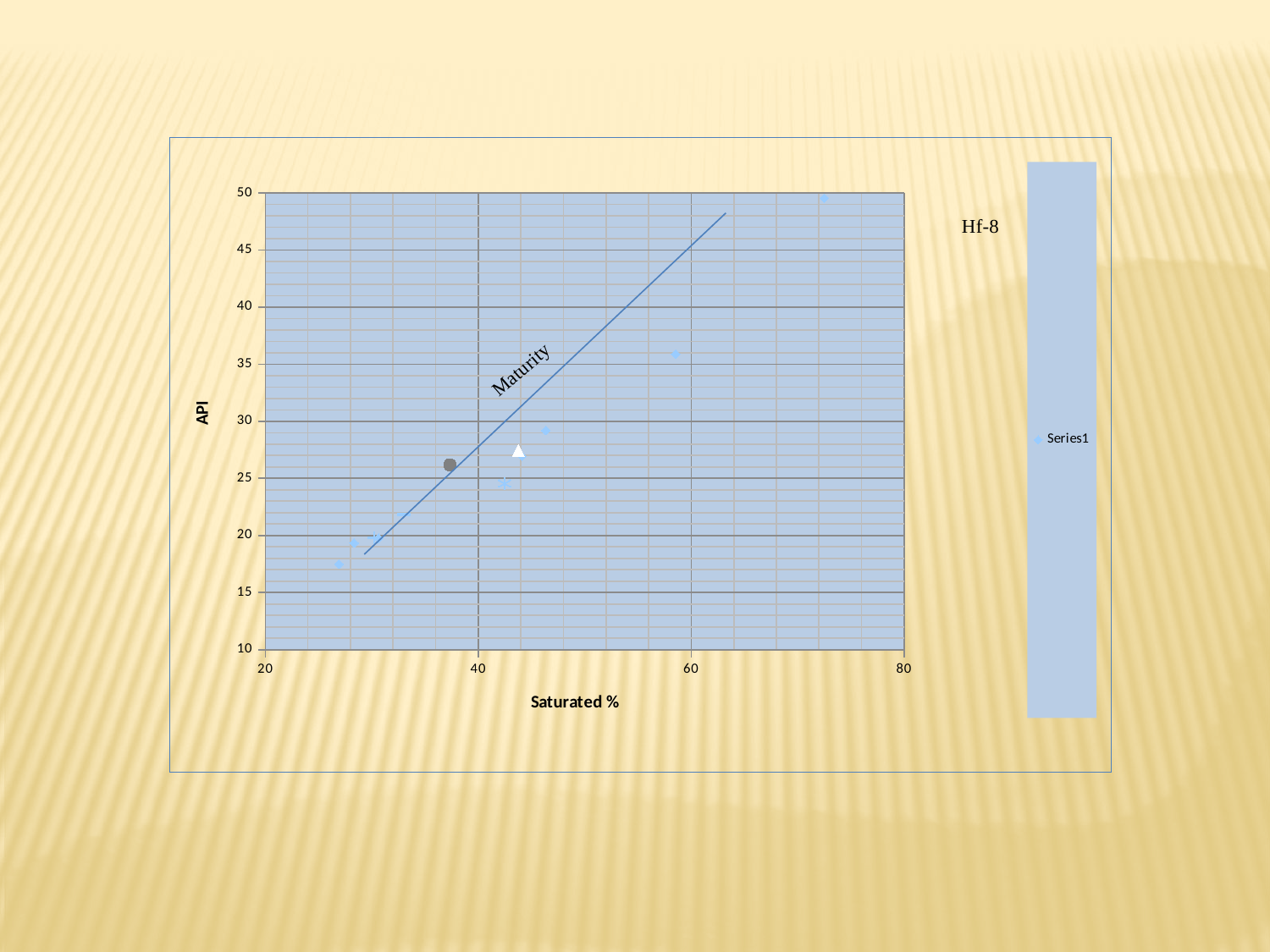
Do the API values generally rise or fall as Saturated % increases? rise Is the Saturated % value of the highest point greater or less than 60? greater Is the API value of the rightmost point (near 72 Saturated %) greater or less than 45? greater How many series does the legend list? 1 What is the title of the x axis? Saturated % Is the API value of the leftmost point (near 27 Saturated %) greater or less than 20? less What is the title of the y axis? API What kind of chart is shown on the slide? scatter chart What is the name of the series listed in the legend? Series1